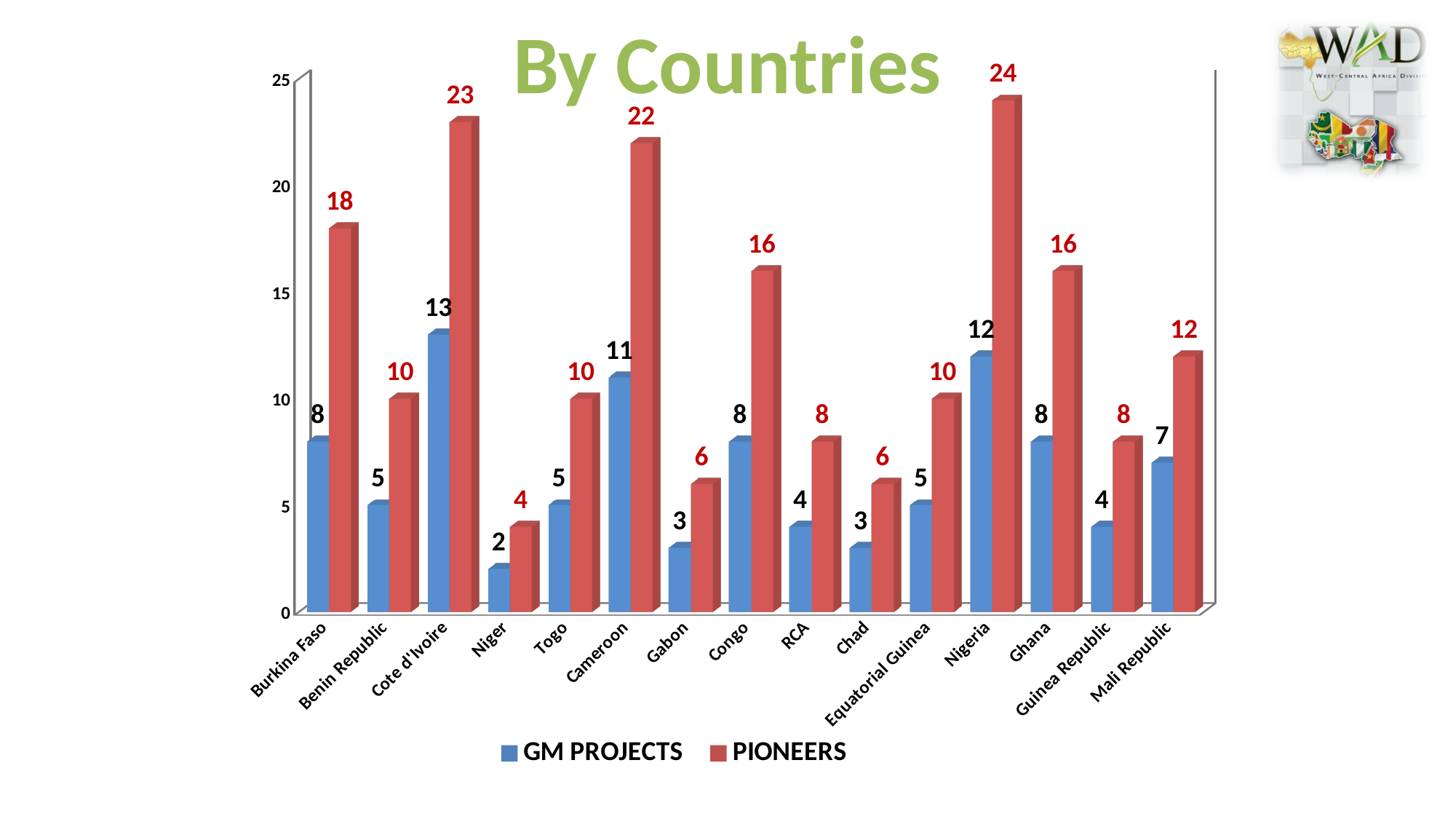
Which is larger, the GM PROJECTS value for Nigeria or the GM PROJECTS value for Cote d'Ivoire? Cote d'Ivoire Which country has the highest PIONEERS value? Nigeria Is the PIONEERS value for Congo greater or less than 15? greater How many series does the legend list? 2 What is the GM PROJECTS value for Cote d'Ivoire? 13 What is the title of the chart? By Countries What is the PIONEERS value for Mali Republic? 12 What is the difference between the PIONEERS and GM PROJECTS values for Burkina Faso? 10 How many countries are shown on the x axis? 15 What kind of chart is shown on the slide? Bar chart Which country has the lowest GM PROJECTS value? Niger What is the PIONEERS value for Cameroon? 22